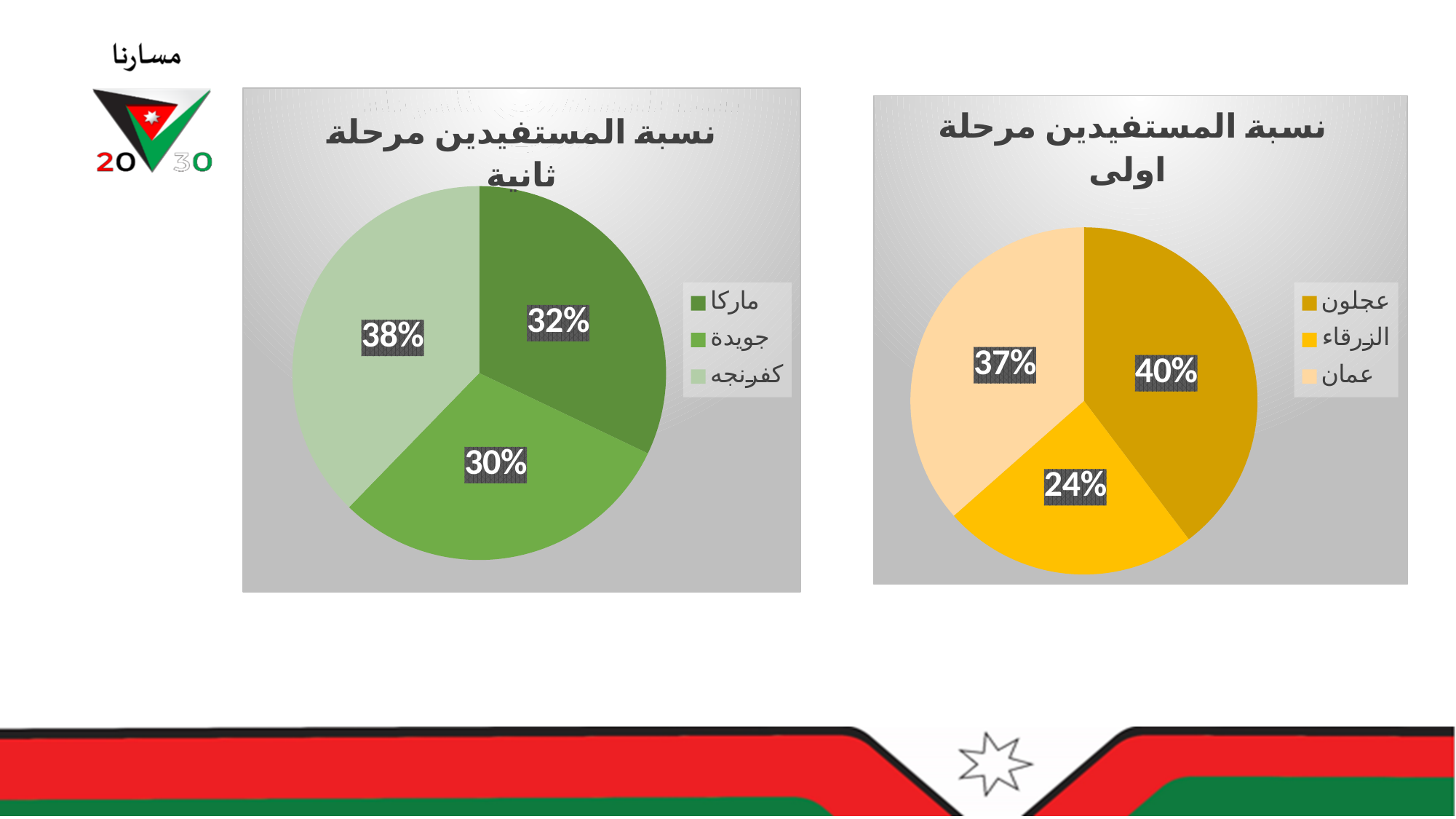
In the chart titled "نسبة المستفيدين مرحلة اولى", what is the difference in percentage points between عجلون and الزرقاء? 16 In the chart titled "نسبة المستفيدين مرحلة ثانية", what percentage is shown for كفرنجه? 38% In the chart titled "نسبة المستفيدين مرحلة اولى", which category has the smallest share? الزرقاء In the chart titled "نسبة المستفيدين مرحلة ثانية", which is larger, the share for ماركا or the share for جويدة? ماركا In the chart titled "نسبة المستفيدين مرحلة اولى", which category has the largest share? عجلون In the chart titled "نسبة المستفيدين مرحلة اولى", what percentage is shown for عمان? 37% In the chart titled "نسبة المستفيدين مرحلة ثانية", which category has the largest share? كفرنجه In the chart titled "نسبة المستفيدين مرحلة ثانية", what percentage is shown for ماركا? 32% How many categories does the chart titled "نسبة المستفيدين مرحلة ثانية" show? 3 In the chart titled "نسبة المستفيدين مرحلة اولى", which category is shown in the lightest colour? عمان What kind of chart is the chart titled "نسبة المستفيدين مرحلة اولى"? Pie chart In the chart titled "نسبة المستفيدين مرحلة اولى", what percentage is shown for الزرقاء? 24%